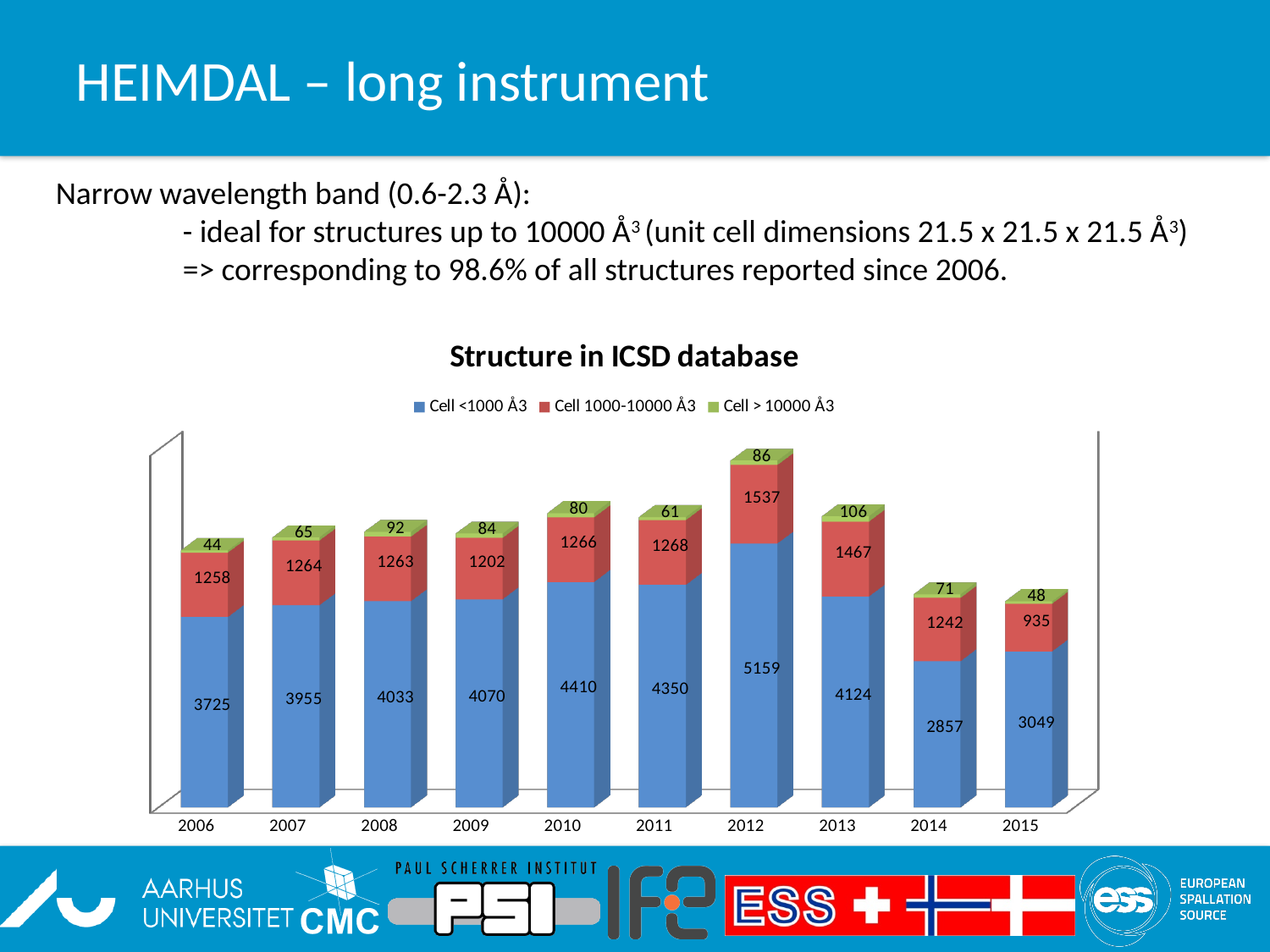
Which is larger, the Cell <1000 Å3 value for 2010 or for 2011? 2010 Which year has the highest value for Cell <1000 Å3? 2012 What is the value for Cell <1000 Å3 in 2012? 5159 What is the total of the stacked bar for 2015? 4032 Which year has the lowest value for Cell > 10000 Å3? 2006 Which year has the lowest value for Cell 1000-10000 Å3? 2015 What is the value for Cell > 10000 Å3 in 2009? 84 How many years are shown on the x axis? 10 What is the value for Cell 1000-10000 Å3 in 2013? 1467 What type of chart is shown? Stacked bar chart How many series does the legend list? 3 What is the difference between the Cell <1000 Å3 values for 2012 and 2014? 2302